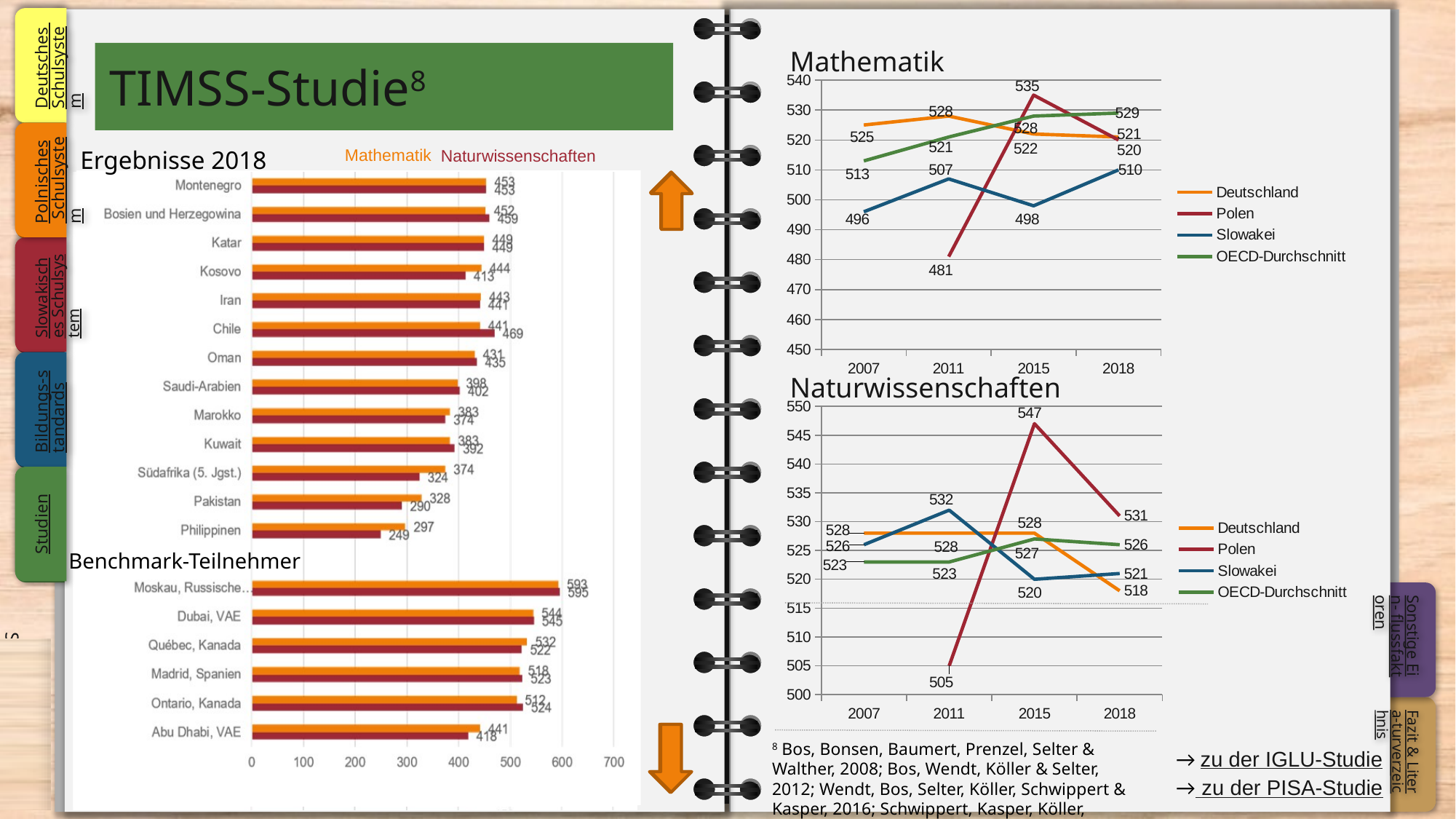
In the Naturwissenschaften chart, what is the value for Polen in 2015? 547 In the Mathematik chart, what is the value for Slowakei in 2007? 496 What kind of chart is the Ergebnisse 2018 chart on the left? bar chart In the Mathematik chart, which series has the lowest value in 2011? Polen In the Ergebnisse 2018 chart, what is the difference between the Mathematik and Naturwissenschaften values for Philippinen? 48 In the Mathematik chart, what is the value for Polen in 2015? 535 In the Naturwissenschaften chart, which series has the highest value in 2011? Slowakei In the Mathematik chart, how many series does the legend list? 4 In the Naturwissenschaften chart, does the Deutschland series rise or fall from 2015 to 2018? fall In the Mathematik chart, what is the difference between the OECD-Durchschnitt and Deutschland values in 2018? 8 In the Naturwissenschaften chart, is the value for Deutschland in 2018 larger or smaller than the value for Slowakei in 2018? smaller In the Ergebnisse 2018 chart, what is the Mathematik value for Moskau? 593